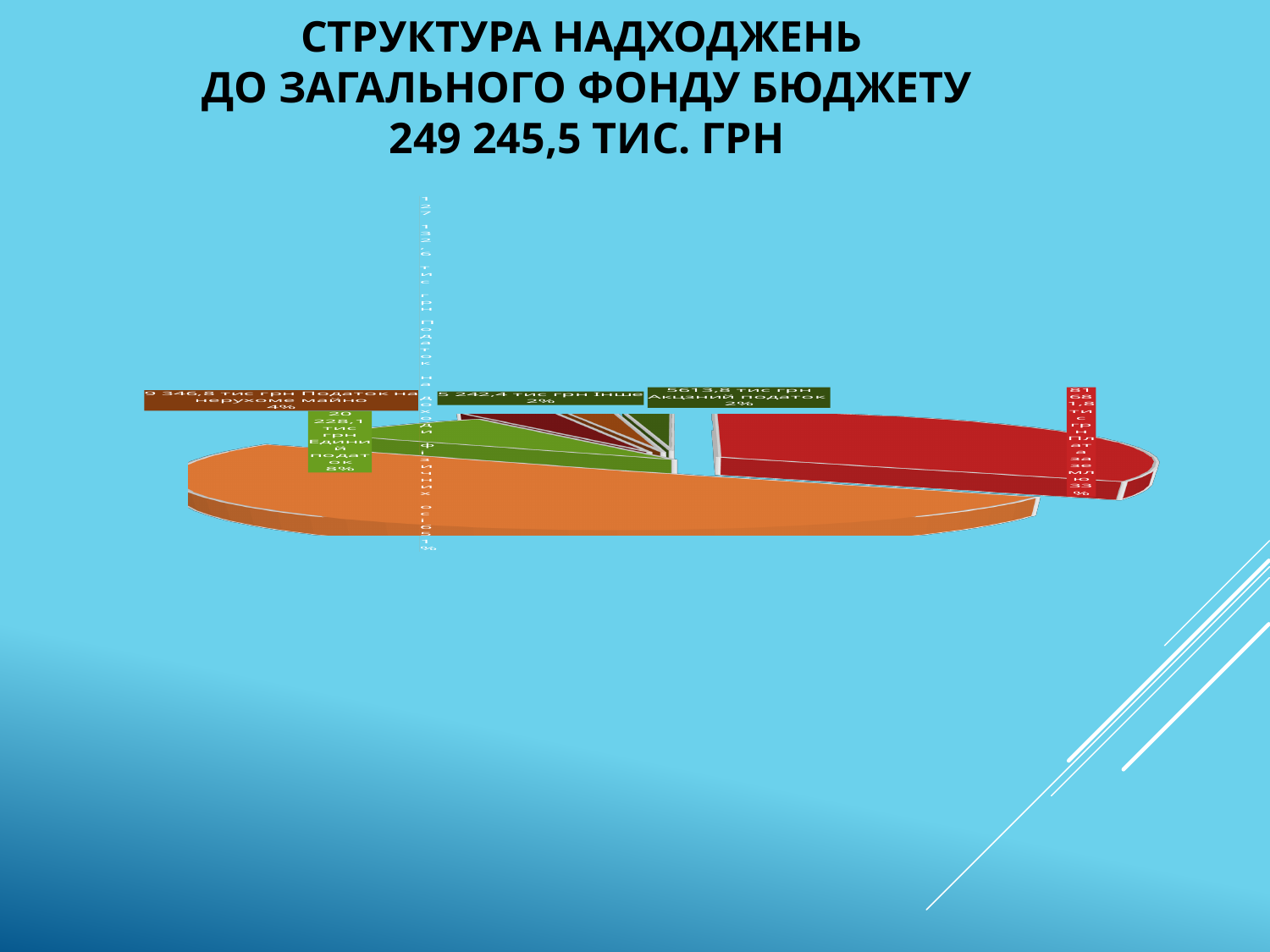
What is the value shown for Акцизний податок? 5613,8 тис грн What share of the pie does Плата за землю represent? 33% Which is larger, the share for Єдиний податок or the share for Податок на нерухоме майно? Єдиний податок What share of the pie does Єдиний податок represent? 8% What kind of chart is shown on the slide? pie chart What is the value shown for Єдиний податок? 20 228,1 тис грн How many slices does the pie chart have? 6 What share of the pie does Податок на нерухоме майно represent? 4% What is the value shown for Податок на нерухоме майно? 9 346,8 тис грн Which category has the largest share of the pie? Податок на доходи фізичних осіб What total amount is stated in the chart title? 249 245,5 тис. грн